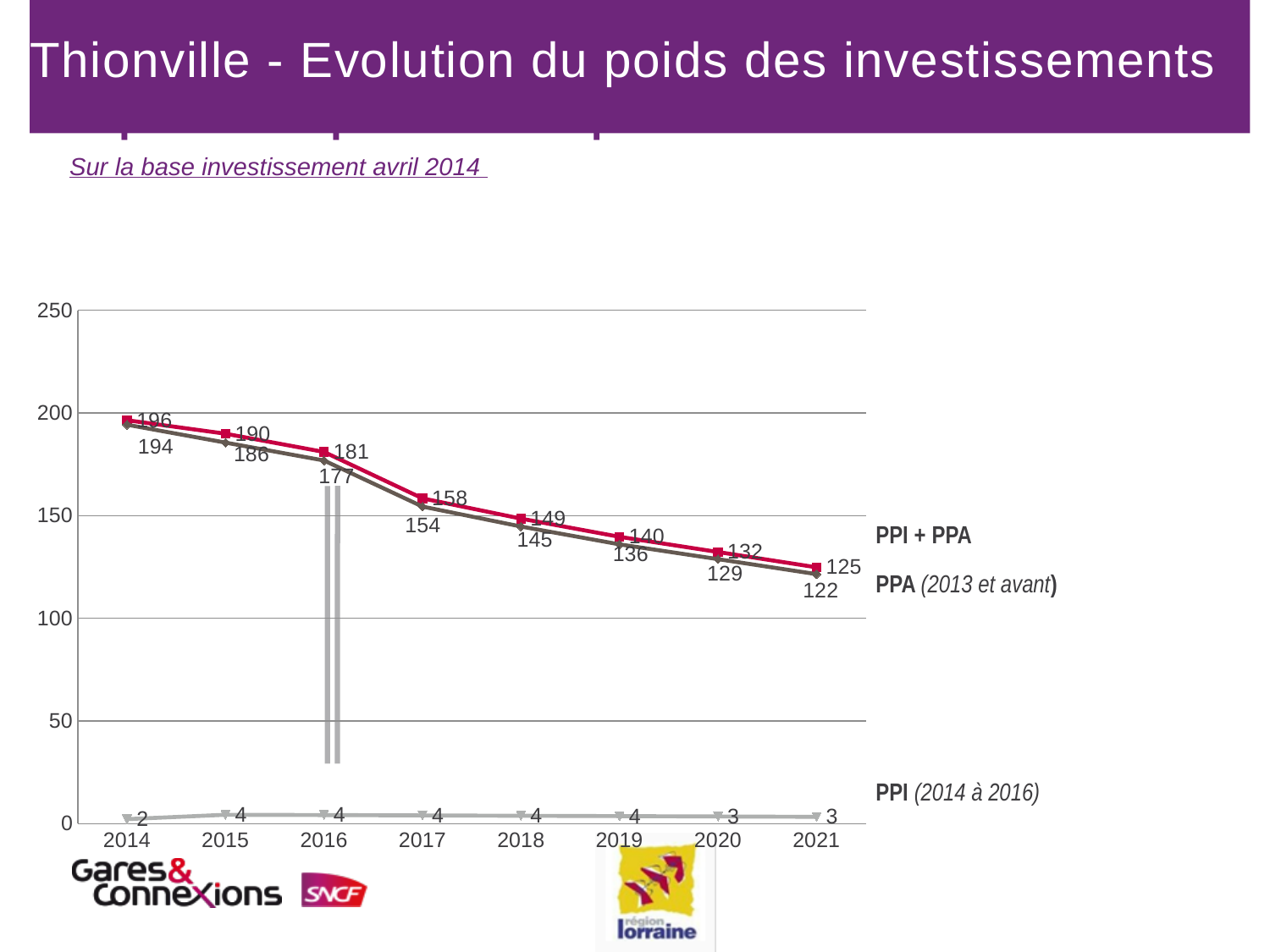
In which year is PPI + PPA at its highest? 2014 What is the difference between PPI + PPA in 2014 and in 2021? 71 In which year is PPA (2013 et avant) at its lowest? 2021 What is the value of PPI + PPA in 2014? 196 What is the value of PPA (2013 et avant) in 2017? 154 What type of chart is shown on the slide? line chart Does PPI + PPA rise or fall from 2014 to 2021? fall Which is larger: PPA (2013 et avant) in 2016 or in 2018? 2016 How many years are shown on the x axis? 8 How many series are plotted on the chart? 3 What is the value of PPI + PPA in 2021? 125 What is the value of PPI (2014 à 2016) in 2020? 3